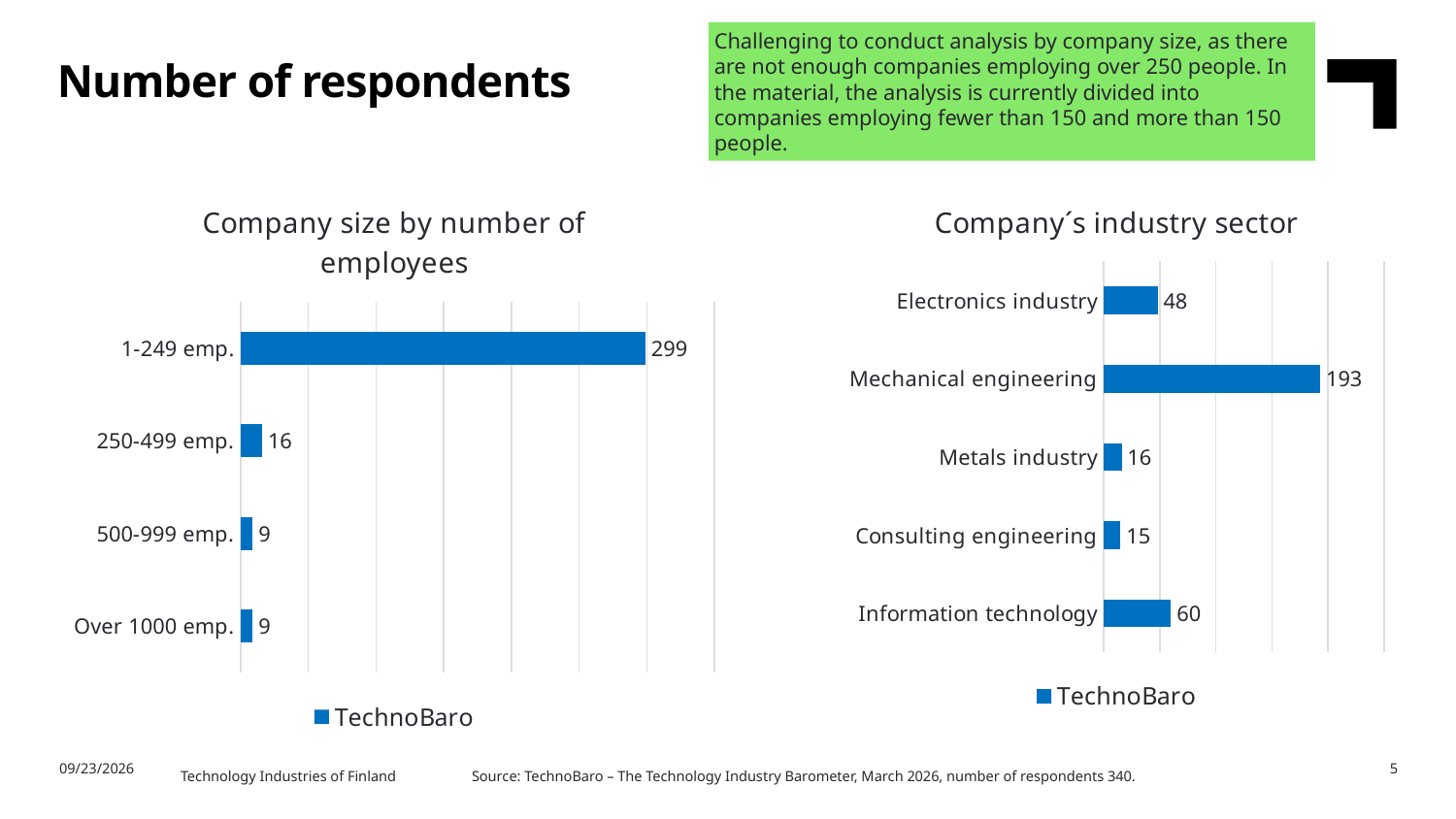
In the 'Company size by number of employees' chart, what is the difference between the values for 1-249 emp. and 250-499 emp.? 283 In the 'Company's industry sector' chart, which is larger, the value for Electronics industry or the value for Information technology? Information technology In the 'Company size by number of employees' chart, what is the value for 250-499 emp.? 16 In the 'Company's industry sector' chart, what is the difference between the values for Mechanical engineering and Electronics industry? 145 What kind of chart is the 'Company's industry sector' chart? Bar chart In the 'Company size by number of employees' chart, how many categories are shown? 4 How many series does the legend of the 'Company size by number of employees' chart list? 1 In the 'Company's industry sector' chart, what is the value for Information technology? 60 In the 'Company's industry sector' chart, what is the value for Mechanical engineering? 193 In the 'Company size by number of employees' chart, what is the value for 1-249 emp.? 299 In the 'Company size by number of employees' chart, which category has the highest value? 1-249 emp. In the 'Company's industry sector' chart, which category has the lowest value? Consulting engineering